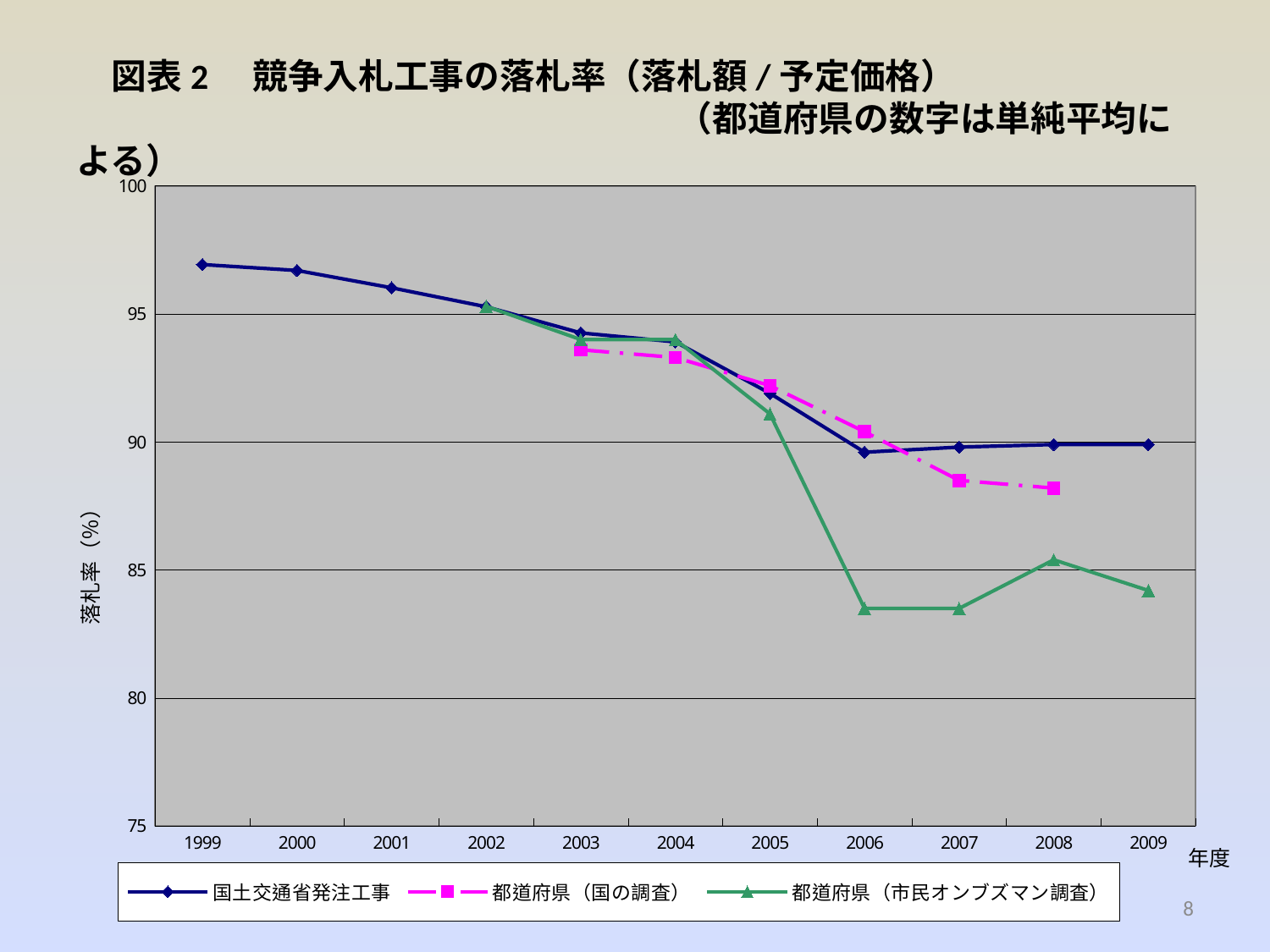
How many series does the legend list? 3 Is the value for 国土交通省発注工事 in 1999 greater or less than 95? greater How many years are shown on the x axis? 11 What kind of chart is shown on the slide? Line chart In 2009, which series has the larger value: 国土交通省発注工事 or 都道府県（市民オンブズマン調査）? 国土交通省発注工事 Is the value for 都道府県（市民オンブズマン調査） in 2006 greater or less than 85? less Is the value for 都道府県（国の調査） in 2008 greater or less than 90? less Does the 国土交通省発注工事 series rise or fall from 1999 to 2006? Fall What is the label of the y axis? 落札率（%） Which series has the highest value in 2007? 国土交通省発注工事 Does the 都道府県（市民オンブズマン調査） series rise or fall from 2002 to 2006? Fall